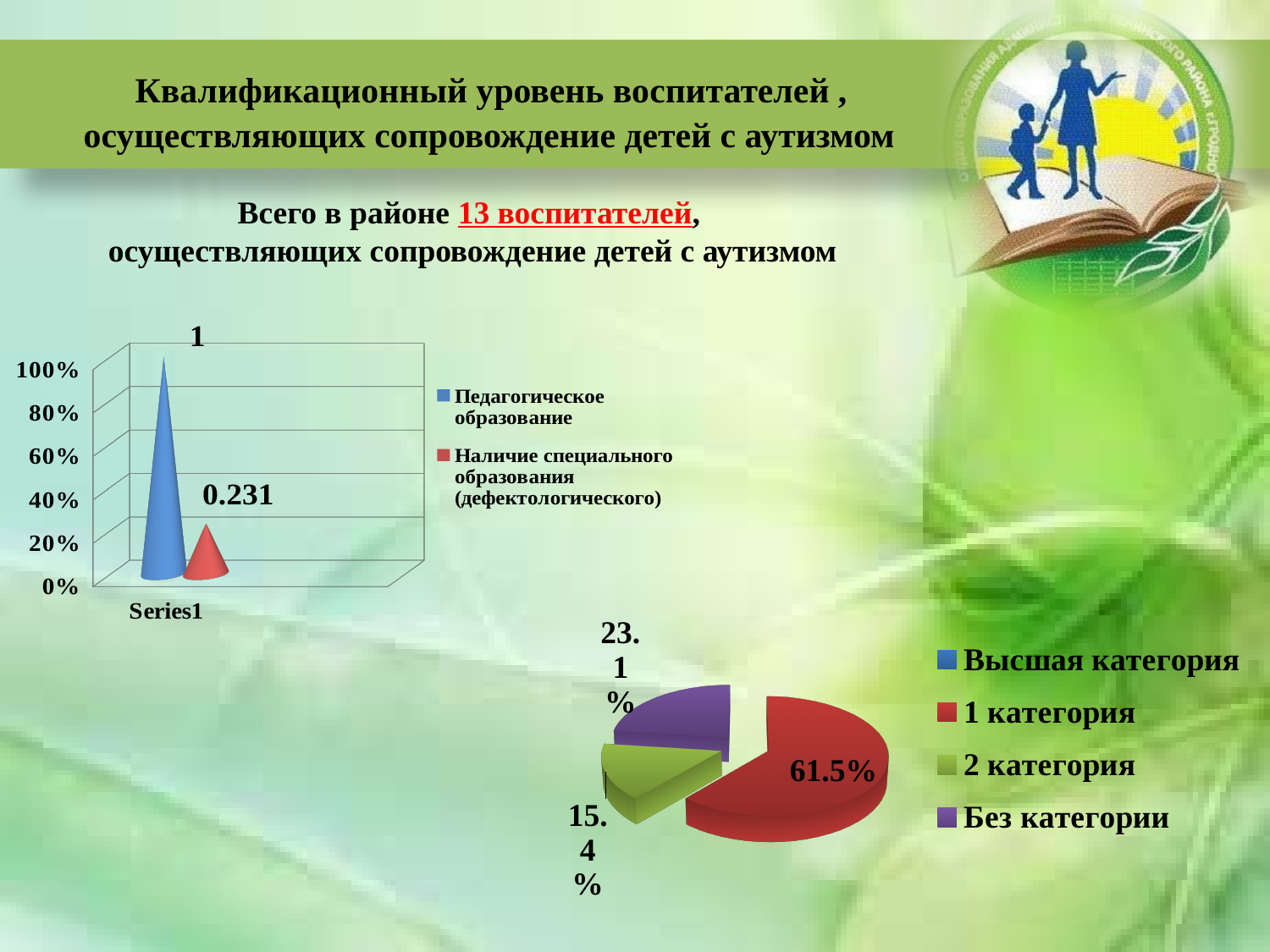
In the bar chart on the left, what is the value for Наличие специального образования (дефектологического)? 0.231 In the pie chart on the right, what share does 2 категория have? 15.4% In the pie chart on the right, what share does Без категории have? 23.1% How many series does the legend of the bar chart on the left list? 2 In the pie chart on the right, which is larger: 2 категория or Без категории? Без категории In the pie chart on the right, what share does 1 категория have? 61.5% What kind of chart is the chart on the left of the slide? bar chart In the pie chart on the right, which category has the largest slice? 1 категория In the bar chart on the left, what is the difference between the values for Педагогическое образование and Наличие специального образования (дефектологического)? 0.769 How many entries does the legend of the pie chart on the right list? 4 In the bar chart on the left, what is the value for Педагогическое образование? 1 In the bar chart on the left, which series has the higher value? Педагогическое образование